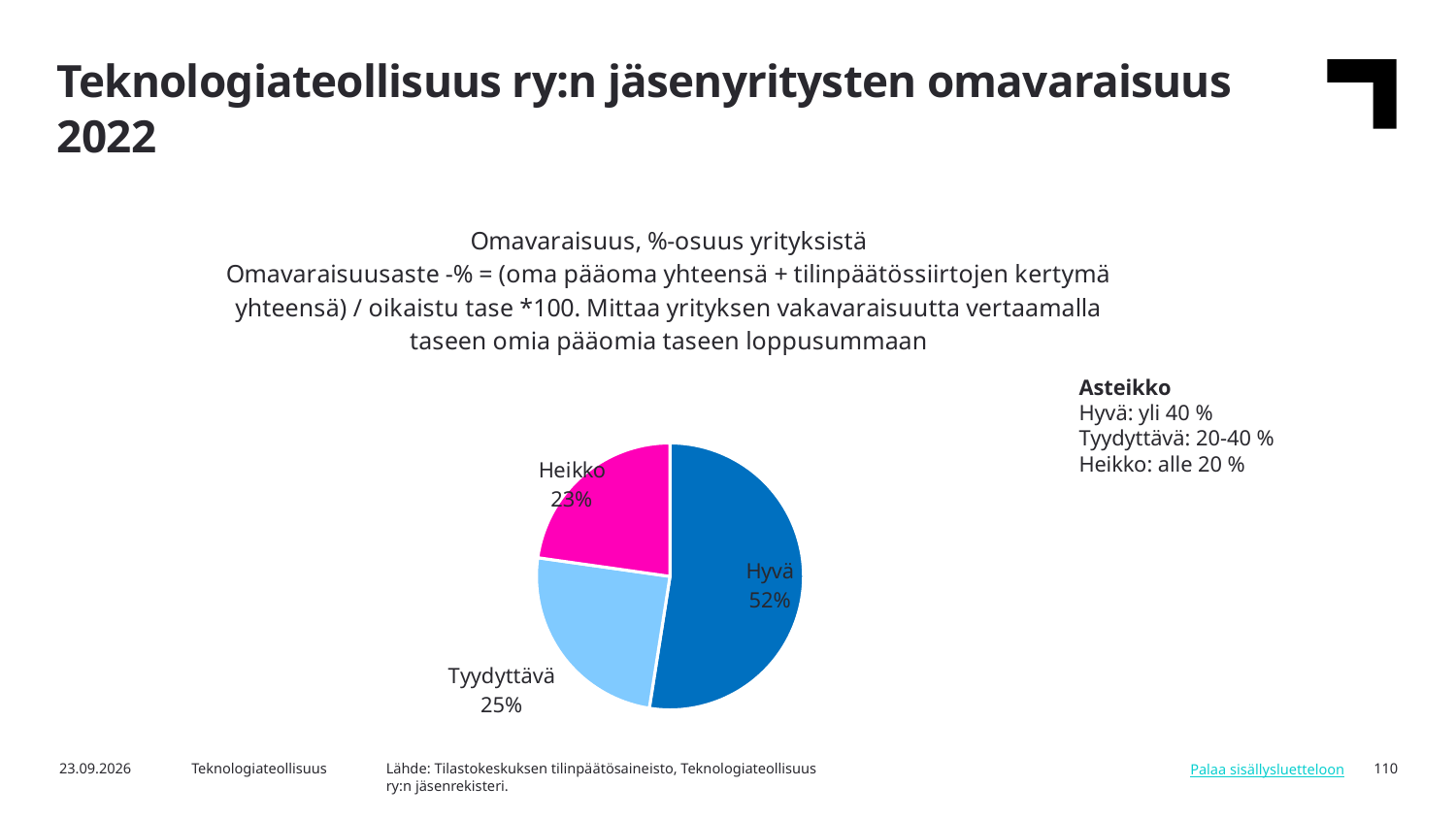
What share of companies falls in the Tyydyttävä category? 25% Which category has the largest share of the pie? Hyvä What share of companies falls in the Heikko category? 23% What share of companies falls in the Hyvä category? 52% How many slices does the pie chart have? 3 According to the scale (Asteikko) on the slide, what equity ratio counts as Hyvä? yli 40 % Is the share for Hyvä greater or less than 50%? greater What kind of chart is shown on the slide? pie chart What is the difference in percentage points between the Tyydyttävä and Heikko shares? 2 Which category has the smallest share of the pie? Heikko Which is larger, the share for Hyvä or the share for Heikko? Hyvä What is the difference in percentage points between the Hyvä and Tyydyttävä shares? 27